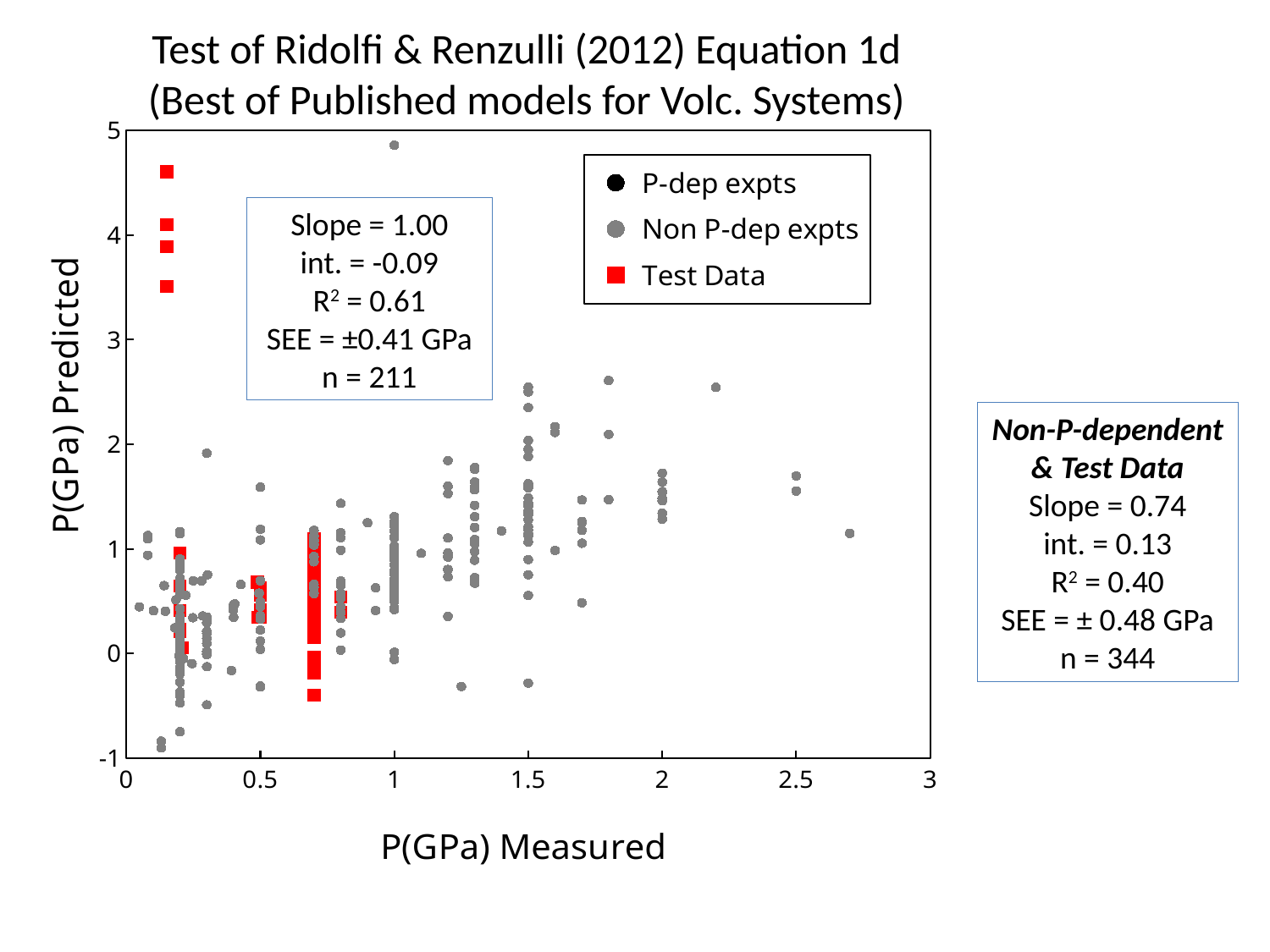
What is the n value reported in the annotation box inside the plot area? 211 What slope is reported in the annotation box inside the plot area? 1.00 What kind of chart is shown on the slide? scatter chart What is the label of the y axis? P(GPa) Predicted What is the title of the chart? Test of Ridolfi & Renzulli (2012) Equation 1d (Best of Published models for Volc. Systems) What is the label of the x axis? P(GPa) Measured How many series does the legend list? 3 What colour are the Test Data markers in the chart? red Is the predicted value of the highest Non P-dep expts point (at measured 1 GPa) greater or less than 4? greater Is the predicted value of the Non P-dep expts point at about 2.7 GPa measured greater or less than 2? less What SEE value is reported in the 'Non-P-dependent & Test Data' box? ± 0.48 GPa What R² value is reported in the 'Non-P-dependent & Test Data' box? 0.40